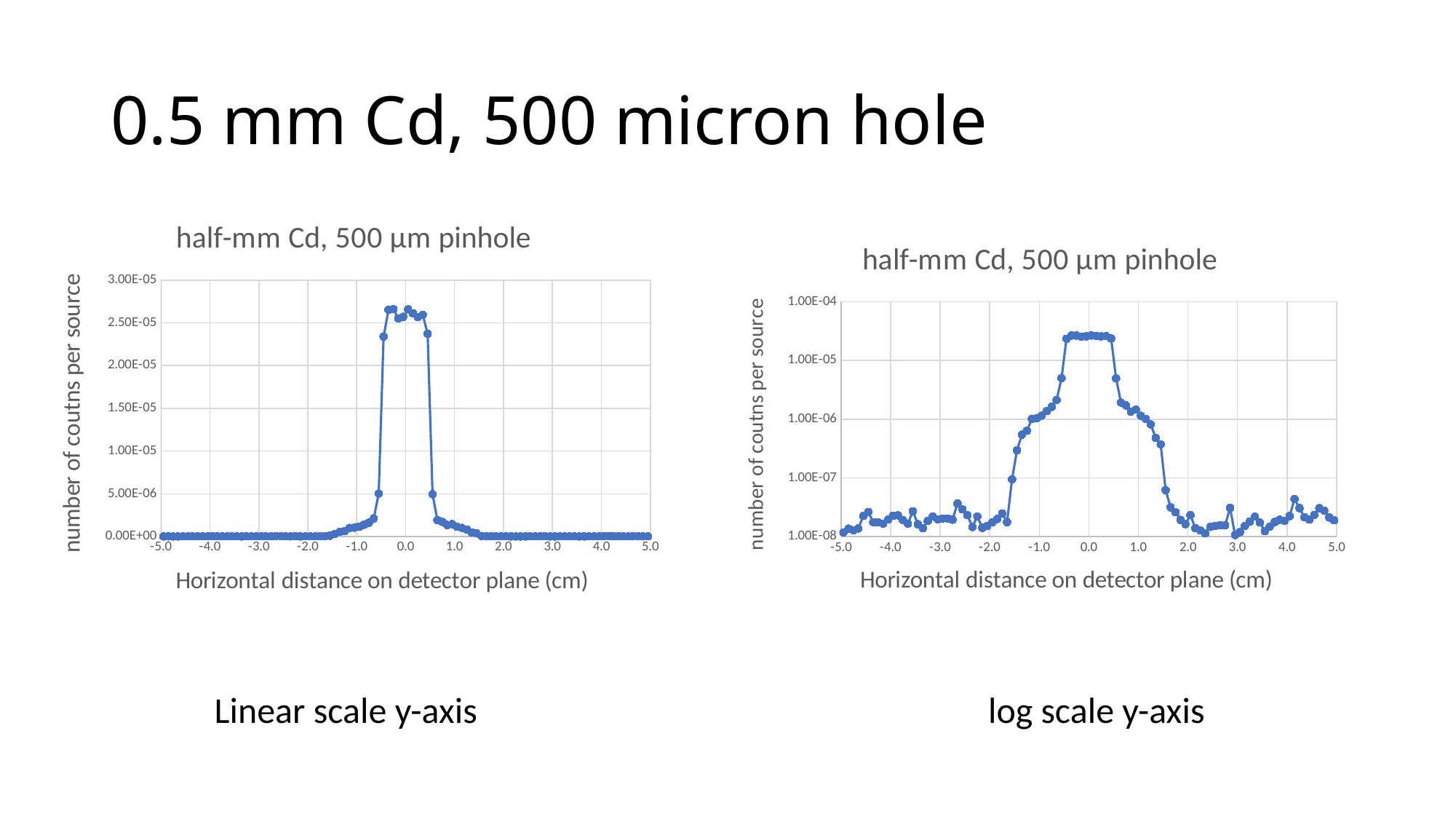
On the left chart (linear scale y-axis), do the values rise or fall as the horizontal distance goes from 0.5 cm to 1.5 cm? fall On the left chart (linear scale y-axis), is the value at a horizontal distance of 0.0 cm greater or less than 2.00E-05? greater On the right chart (log scale y-axis), is the value at a horizontal distance of -4.0 cm greater or less than 1.00E-07? less What is the x-axis label on the right chart? Horizontal distance on detector plane (cm) What is the title of the left chart? half-mm Cd, 500 μm pinhole What kind of chart is the left chart titled 'half-mm Cd, 500 μm pinhole'? line chart On the right chart (log scale y-axis), is the value at a horizontal distance of 2.0 cm greater or less than 1.00E-07? less What kind of chart is the right chart (log scale y-axis)? line chart On the right chart (log scale y-axis), do the values rise or fall as the horizontal distance goes from -2.0 cm to -0.5 cm? rise On the left chart (linear scale y-axis), which is larger: the value at 0.0 cm or the value at 3.0 cm? 0.0 cm